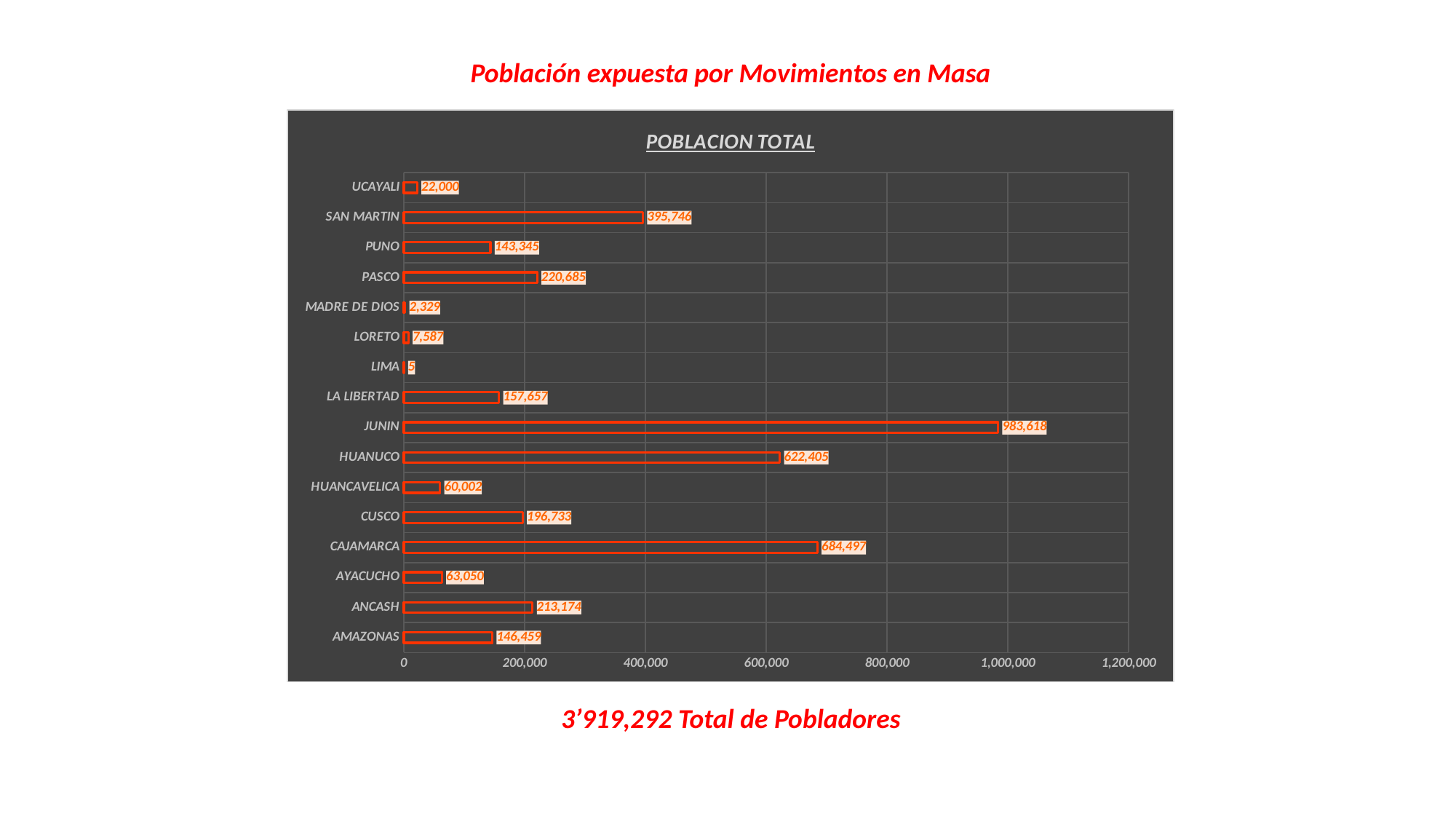
What is the value for JUNIN in the POBLACION TOTAL chart? 983,618 Is the value for HUANUCO greater or less than 600,000? greater Which is larger, the value for CUSCO or the value for LA LIBERTAD? CUSCO What kind of chart is shown on the slide? bar chart How many categories are shown in the chart? 16 What is the title of the chart? POBLACION TOTAL What is the difference between the values for CAJAMARCA and HUANUCO? 62,092 What is the difference between the values for JUNIN and CAJAMARCA? 299,121 What is the value for CAJAMARCA? 684,497 Which category has the lowest value? LIMA Which category has the highest value? JUNIN What is the value for MADRE DE DIOS? 2,329